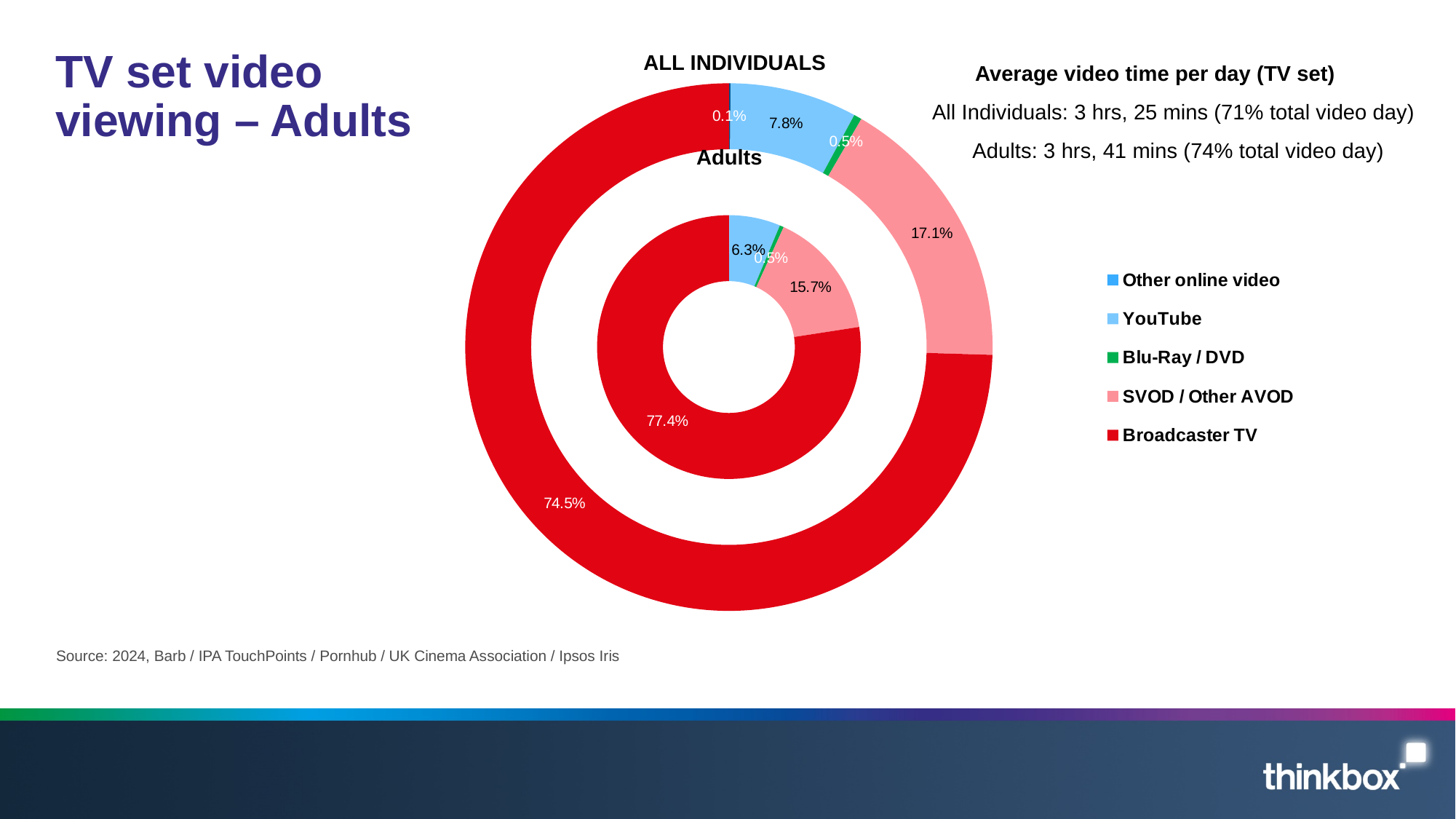
In the Adults ring, what is the share for YouTube? 6.3% How many series does the legend list? 5 What is the difference between the Broadcaster TV share for Adults and for ALL INDIVIDUALS? 2.9 percentage points In the ALL INDIVIDUALS ring, what is the share for Other online video? 0.1% Which category has the smallest share in the ALL INDIVIDUALS ring? Other online video Which legend entry is shown in green? Blu-Ray / DVD Is the YouTube share larger for ALL INDIVIDUALS or for Adults? ALL INDIVIDUALS In the ALL INDIVIDUALS ring, what share of TV set video viewing is Broadcaster TV? 74.5% In the ALL INDIVIDUALS ring, what is the share for SVOD / Other AVOD? 17.1% In the Adults ring, what share of TV set video viewing is Broadcaster TV? 77.4% What kind of chart is shown on the slide? Doughnut chart Which category has the largest share in the Adults ring? Broadcaster TV